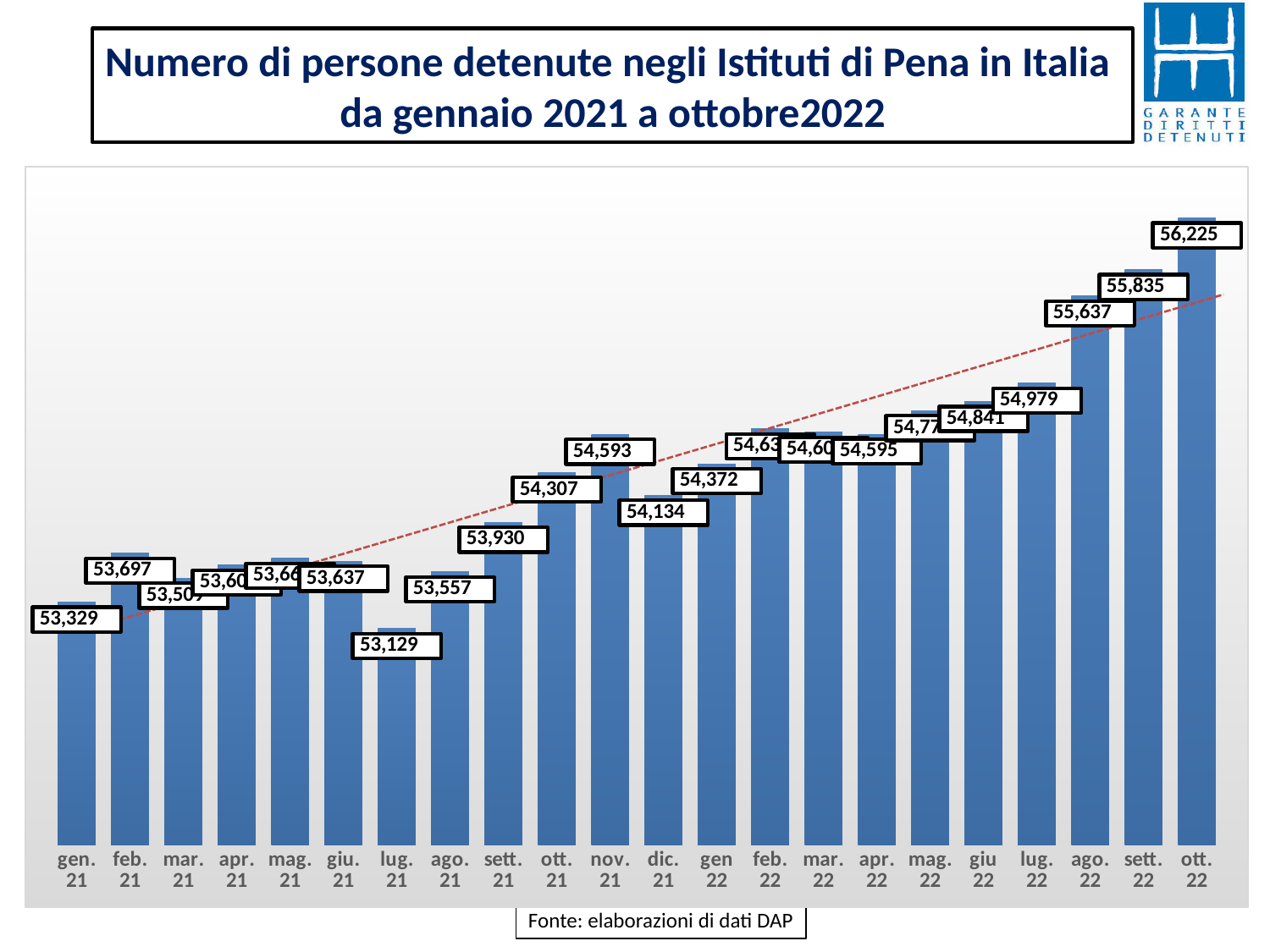
Which month has the lowest number of detained persons? lug. 21 What is the number of detained persons shown for gen. 21? 53,329 What is the difference between the values for sett. 22 and ago. 22? 198 Do the values generally rise or fall from gen. 21 to ott. 22? rise What value is shown for nov. 21? 54,593 What is the difference between the values for ott. 22 and gen. 21? 2,896 Which month has the highest number of detained persons? ott. 22 Which is larger, the value for nov. 21 or the value for dic. 21? nov. 21 How many months are plotted on the chart? 22 What kind of chart is shown on the slide? bar chart What value is shown for ott. 22? 56,225 What value is shown for lug. 21? 53,129